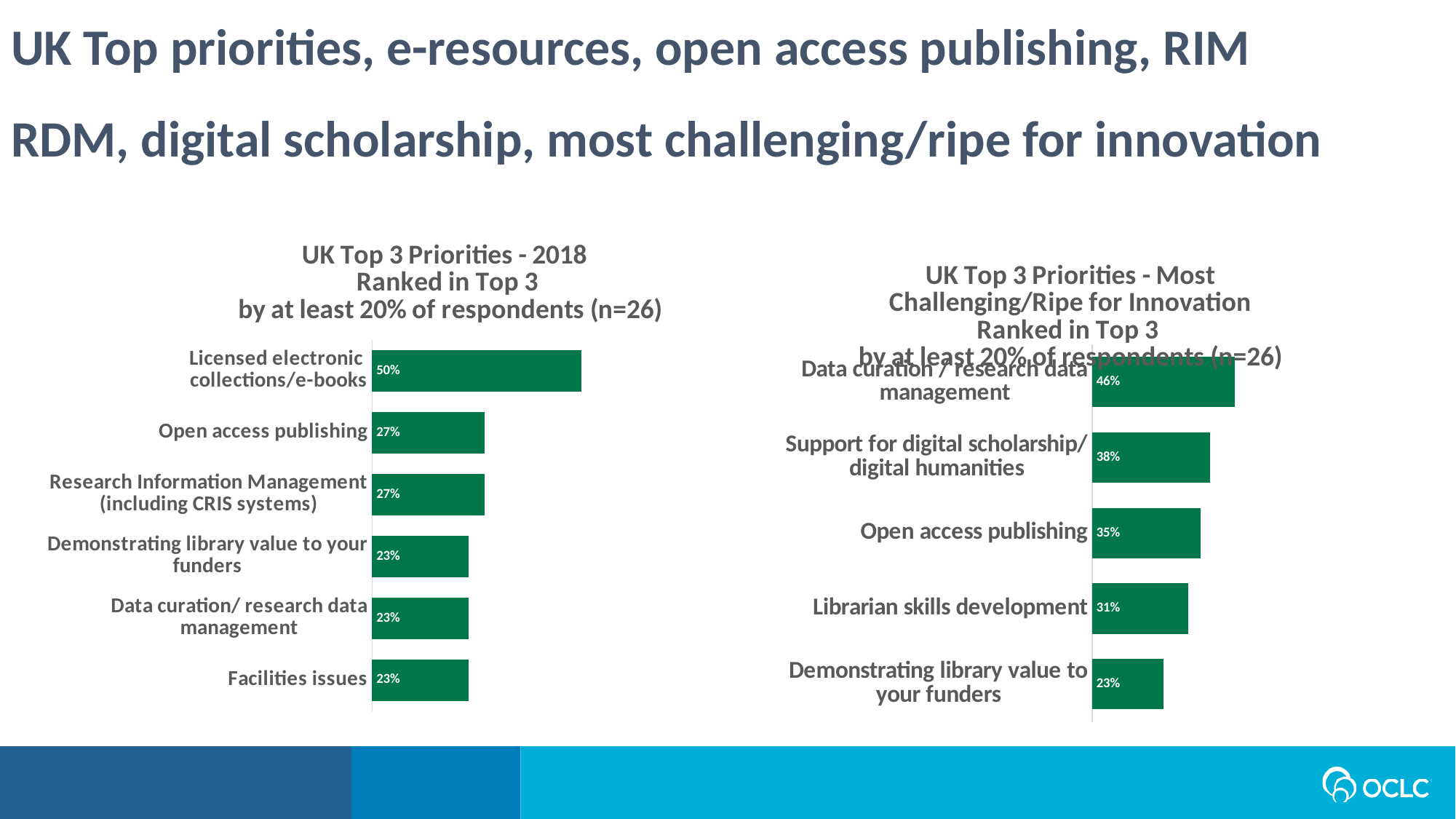
In the right chart (Most Challenging/Ripe for Innovation), what is the difference between Data curation / research data management and Open access publishing? 11% In the left chart (UK Top 3 Priorities - 2018), which category has the highest value? Licensed electronic collections/e-books In the right chart (Most Challenging/Ripe for Innovation), what is the value for Librarian skills development? 31% In the right chart (Most Challenging/Ripe for Innovation), how many categories are shown? 5 In the right chart (Most Challenging/Ripe for Innovation), what is the value for Support for digital scholarship/digital humanities? 38% In the left chart (UK Top 3 Priorities - 2018), what is the difference between Licensed electronic collections/e-books and Facilities issues? 27% In the right chart (Most Challenging/Ripe for Innovation), which is larger: Open access publishing or Librarian skills development? Open access publishing In the left chart (UK Top 3 Priorities - 2018), how many categories are shown? 6 In the right chart (Most Challenging/Ripe for Innovation), which category has the lowest value? Demonstrating library value to your funders What type of chart is the left chart (UK Top 3 Priorities - 2018)? Bar chart In the left chart (UK Top 3 Priorities - 2018), what is the value for Licensed electronic collections/e-books? 50% In the left chart (UK Top 3 Priorities - 2018), what is the value for Open access publishing? 27%